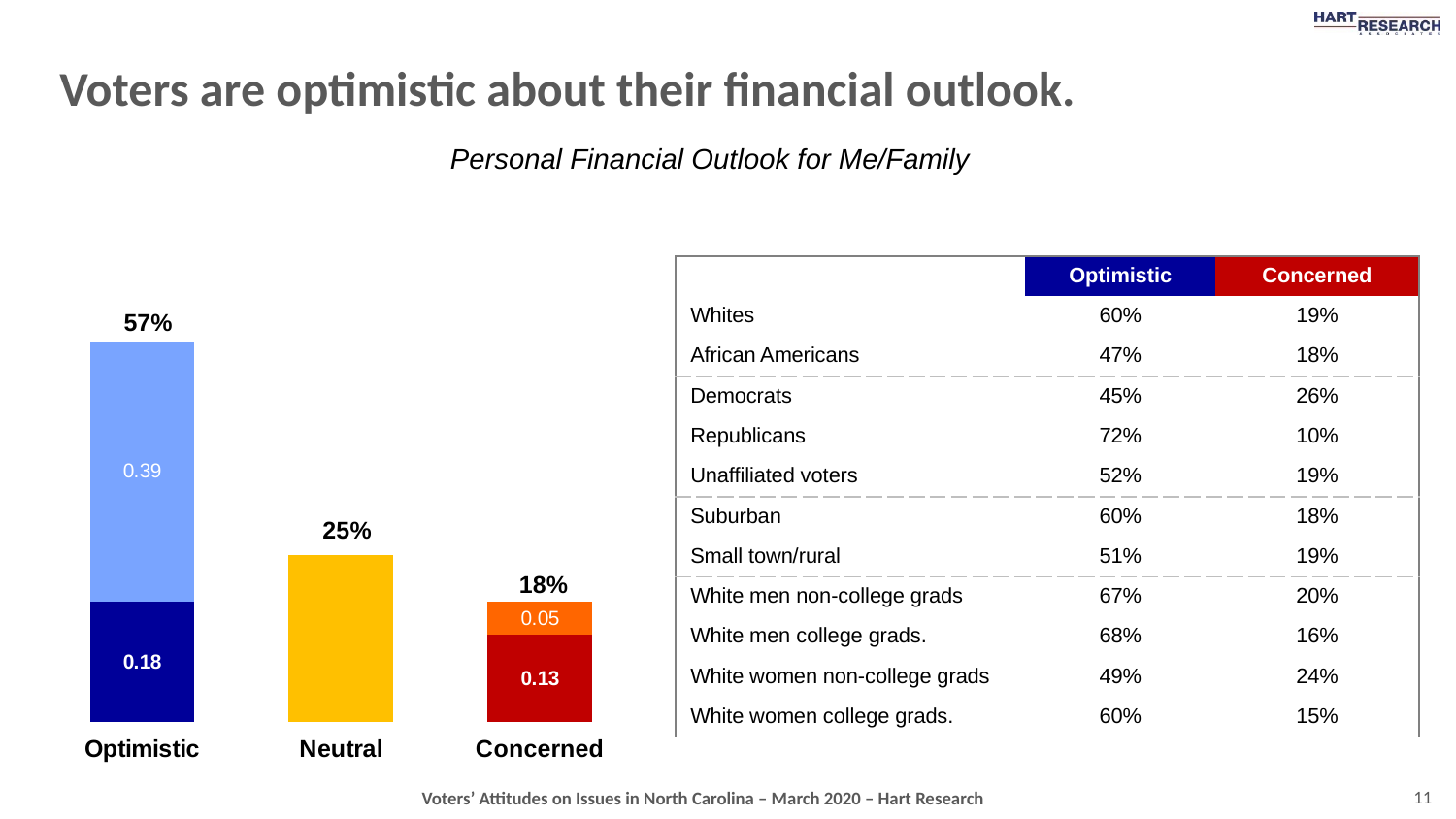
What is the value shown for the Neutral bar? 25% What is the total value shown above the Optimistic bar? 57% How many categories are shown on the x axis of the bar chart? 3 What value is labelled on the orange top segment of the Concerned bar? 0.05 What is the difference between the Optimistic total and the Concerned total? 39 percentage points What is the title shown above the chart? Personal Financial Outlook for Me/Family What is the total value shown above the Concerned bar? 18% Which is larger, the Neutral bar or the Concerned bar? Neutral What value is labelled on the dark blue bottom segment of the Optimistic bar? 0.18 Which category has the lowest bar? Concerned What kind of chart is shown on the left of the slide? Bar chart Which category has the highest bar? Optimistic